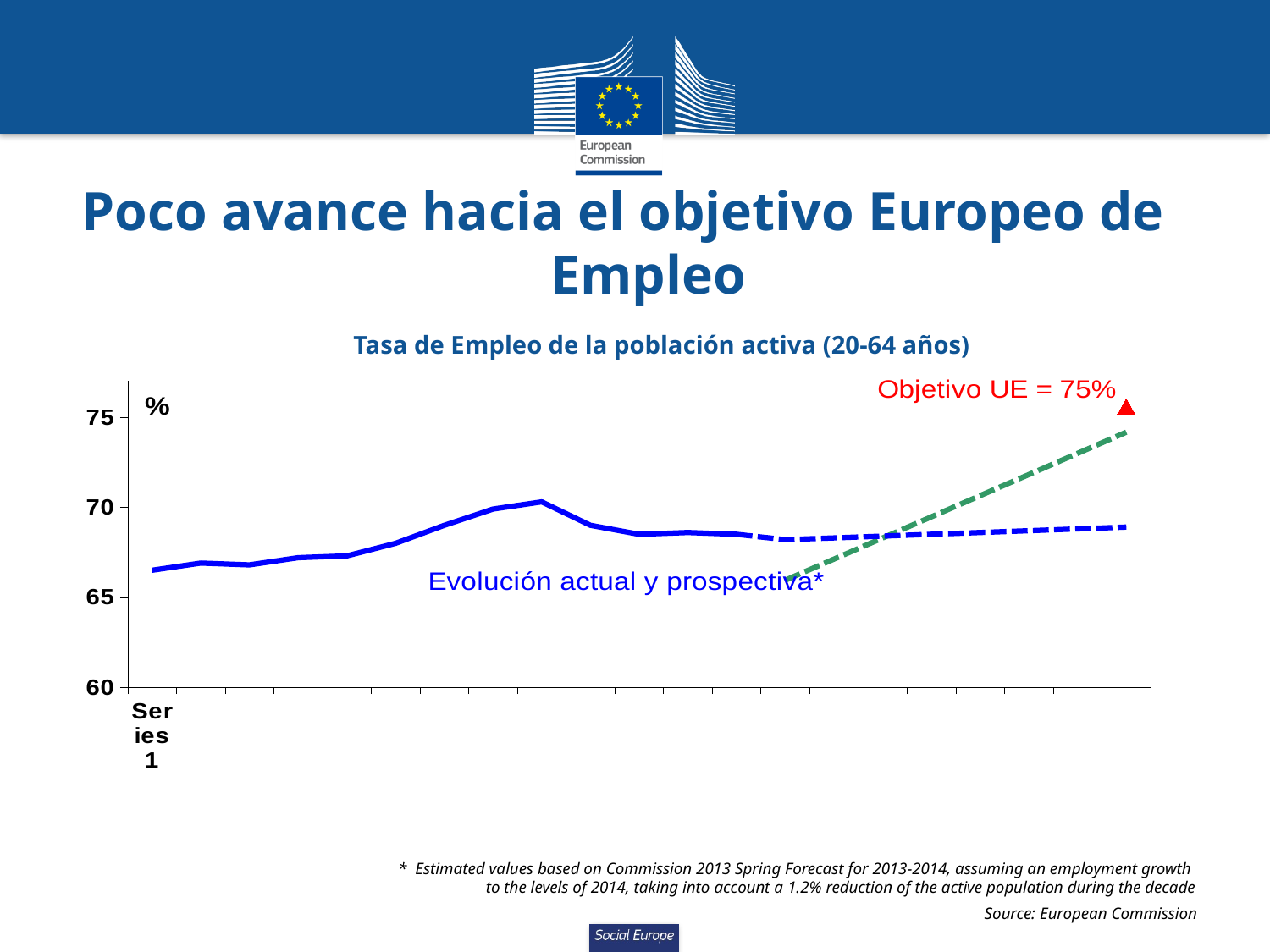
Is the EU target (red triangle) greater or less than the end of the blue dashed projection line? greater What is the title of the chart? Tasa de Empleo de la población activa (20-64 años) Is the highest point of the blue solid line greater or less than 65? greater What is the EU target employment rate shown on the chart (Objetivo UE)? 75% Is the last value of the blue dashed line greater or less than 65? greater Is the first value of the blue solid line greater or less than 70? less What is the lowest value shown on the y axis? 60 What kind of chart is shown on the slide? line chart Does the green dashed line rise or fall along the x axis? rise